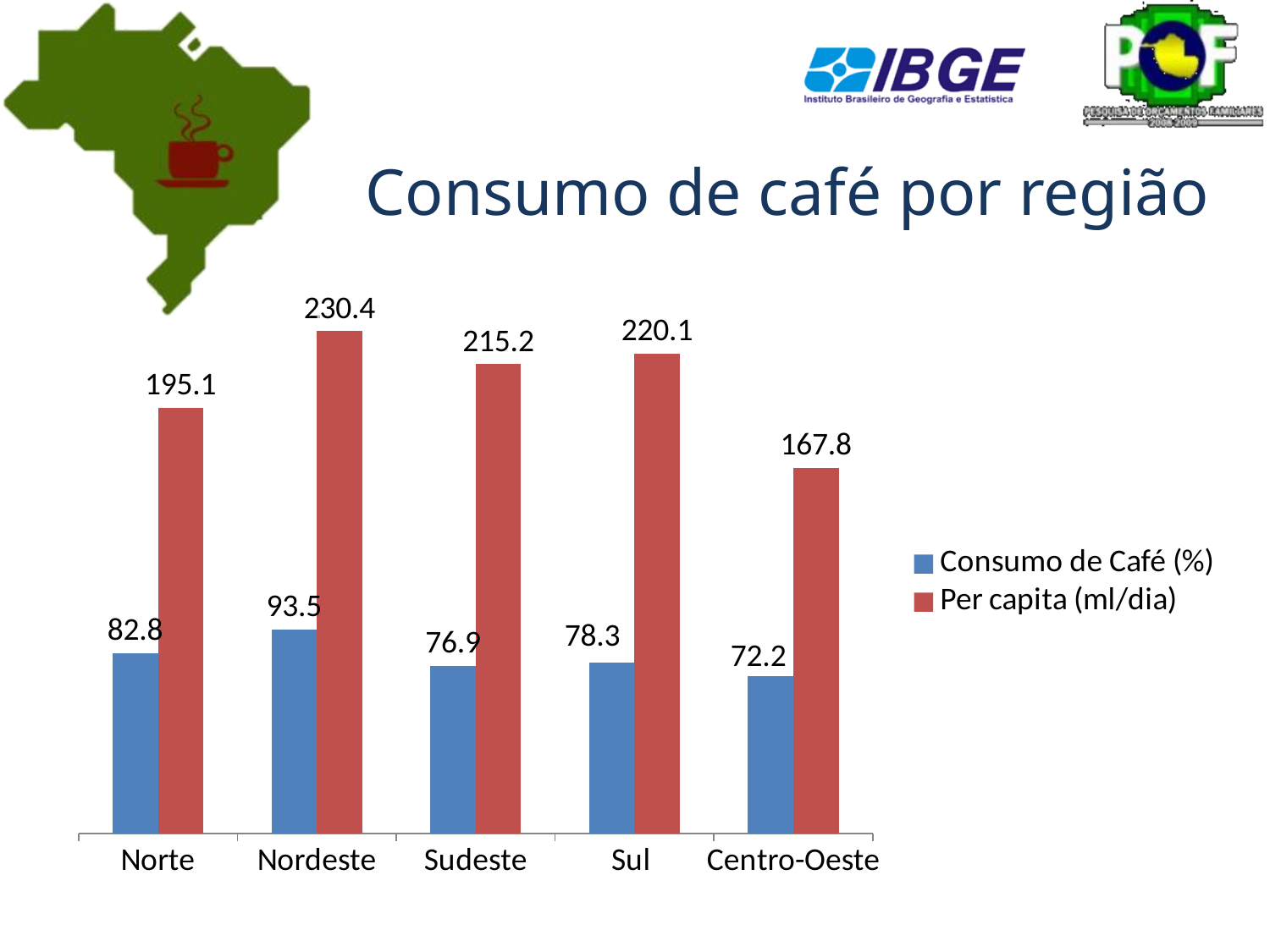
What is the difference between the Per capita (ml/dia) values for Nordeste and Norte? 35.3 Which region has the lowest Per capita (ml/dia) value? Centro-Oeste Which region has the highest Consumo de Café (%)? Nordeste What is the title of the slide? Consumo de café por região Which colour represents the Per capita (ml/dia) series? Red What is the Consumo de Café (%) value for Sul? 78.3 How many series does the legend list? 2 How many regions are shown on the x axis? 5 Which region has the larger Consumo de Café (%): Norte or Sudeste? Norte What is the Per capita (ml/dia) value for Centro-Oeste? 167.8 What is the Per capita (ml/dia) value for Nordeste? 230.4 What kind of chart is shown on the slide? Bar chart